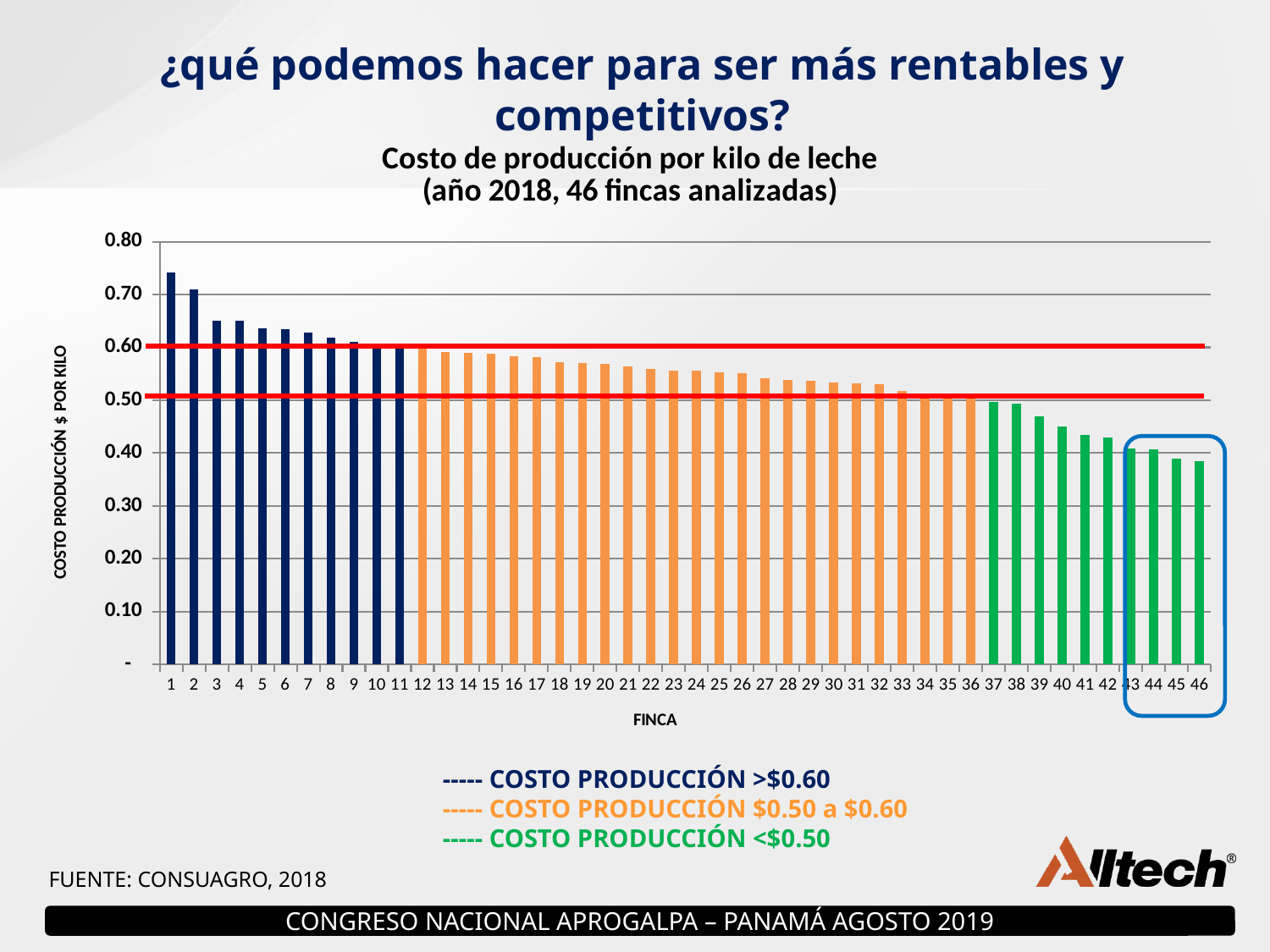
Is the value for finca 37 greater or less than 0.50? less Which finca has the highest cost of production per kilo? 1 Is the value for finca 1 greater or less than 0.70? greater What is the label of the x axis of the chart? FINCA Is the value for finca 20 greater or less than 0.50? greater Which has a lower cost of production per kilo, finca 1 or finca 46? finca 46 Which has a higher cost of production per kilo, finca 5 or finca 30? finca 5 Do the production cost values rise or fall as the finca number increases along the x axis? fall What kind of chart is shown on the slide? bar chart How many fincas (farms) are plotted on the x axis of the chart? 46 According to the legend, what colour are the bars for a production cost below $0.50? green